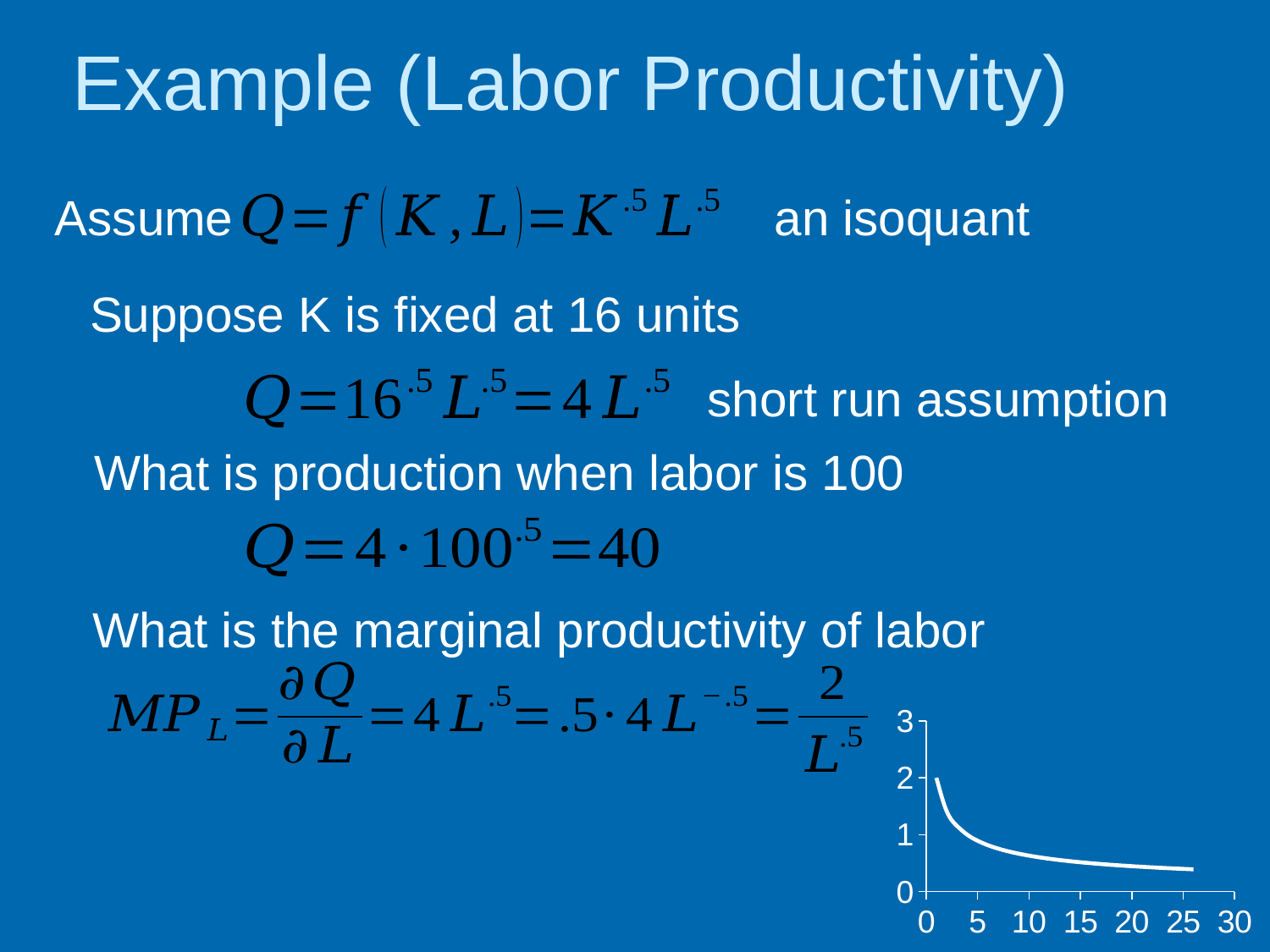
In the chart at the bottom right, is the value at x = 25 greater or less than 1? less In the chart at the bottom right, is the value at x = 5 larger or smaller than the value at x = 25? larger In the chart at the bottom right, is the value at the left end of the curve greater or less than 1? greater What kind of chart is shown in the bottom right of the slide? line chart In the chart at the bottom right, is the value at x = 20 greater or less than 2? less What is the highest tick label on the y axis of the chart at the bottom right? 3 In the chart at the bottom right, do the plotted values rise or fall as the x axis increases? fall What is the highest tick label on the x axis of the chart at the bottom right? 30